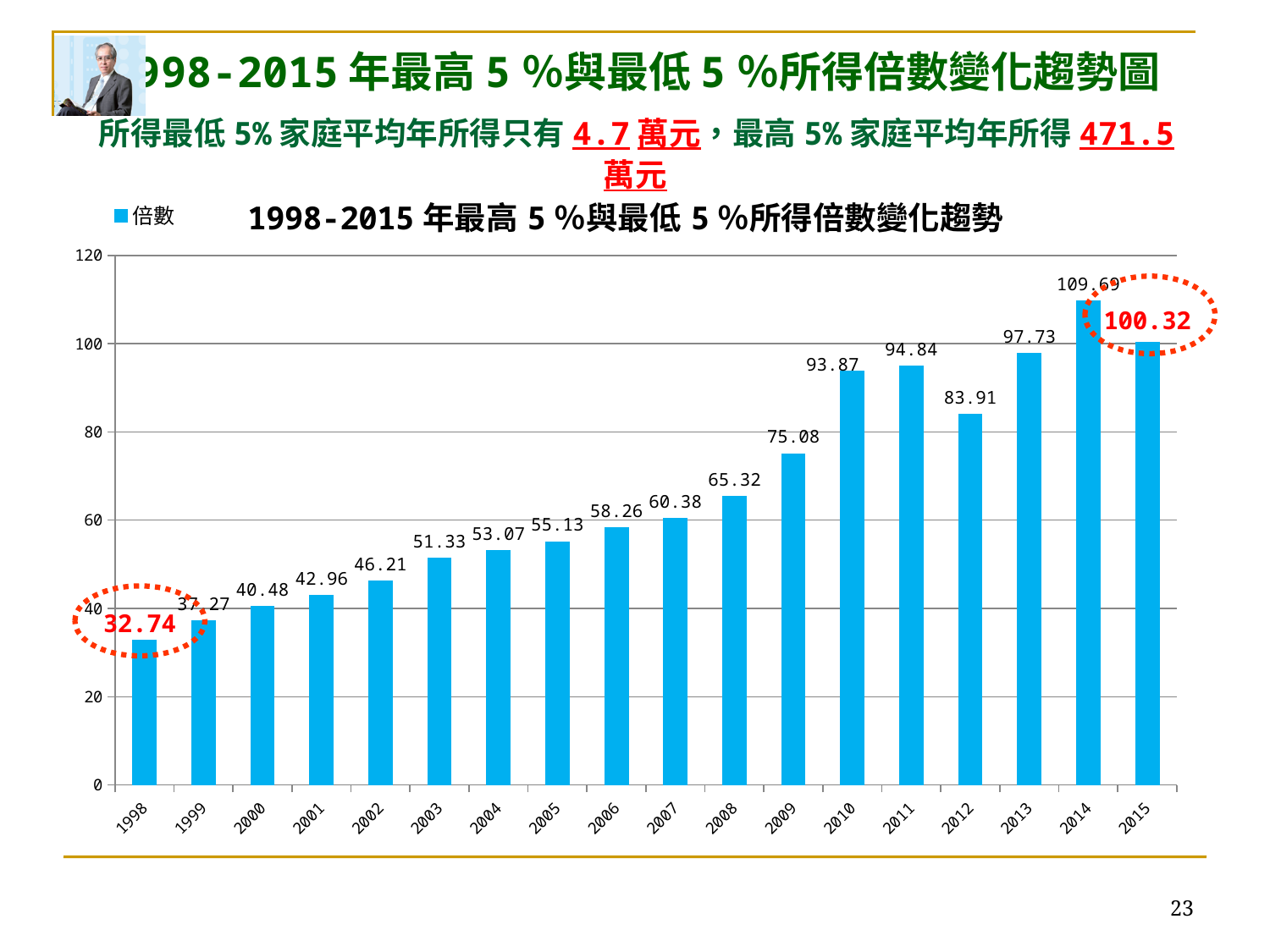
Which year has the lowest value? 1998 What is the value for 2015? 100.32 What is the value for 2012? 83.91 How many years are shown on the x axis? 18 Do the values generally rise or fall from 1998 to 2015? rise Is the value for 2009 greater or less than 80? less Which year has the highest value? 2014 Which is larger, the value for 2012 or the value for 2013? 2013 How many series does the legend list? 1 What is the value for 2010? 93.87 What is the difference between the values for 2015 and 1998? 67.58 What kind of chart is this? bar chart